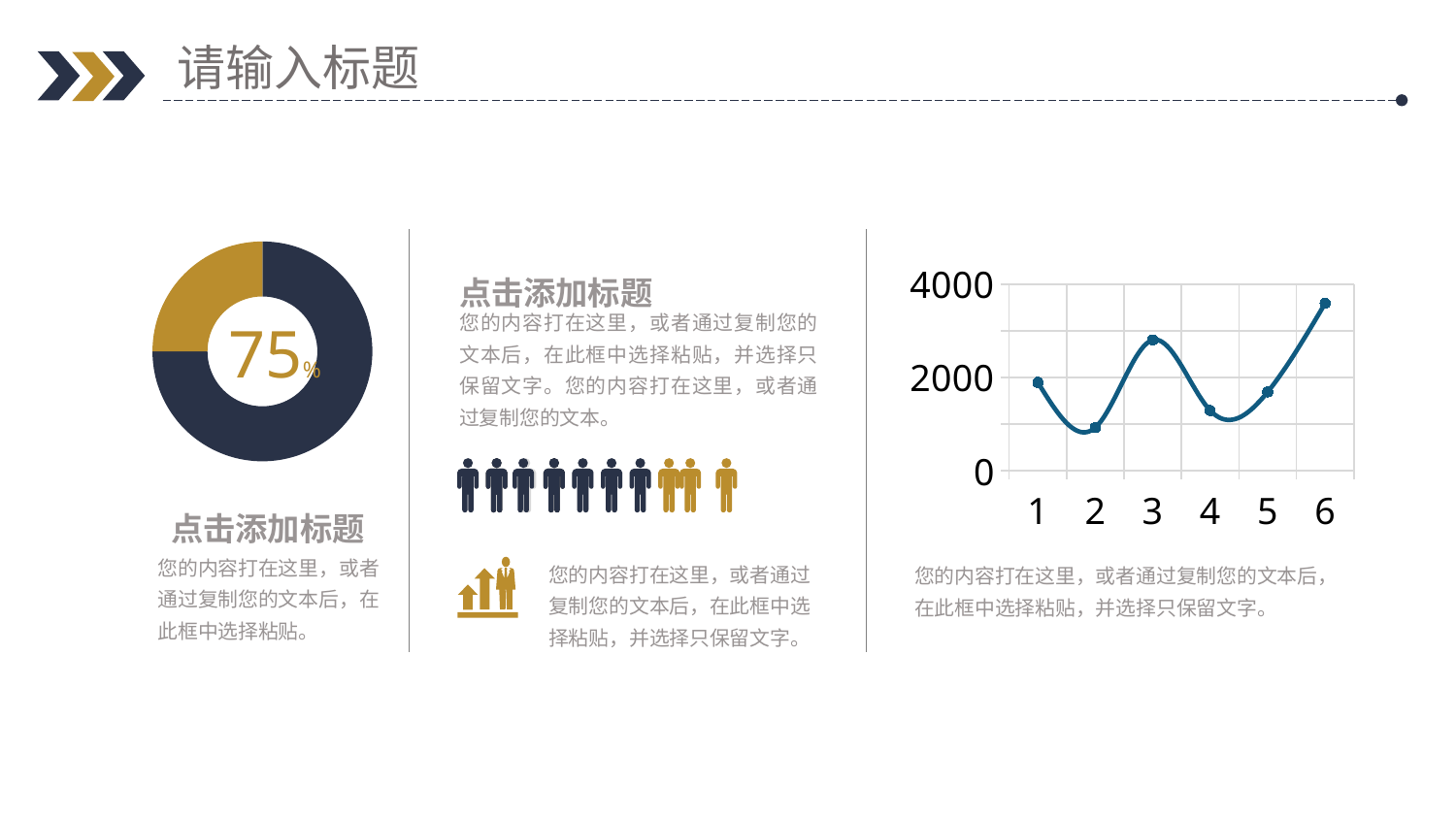
In the line chart on the right, which category has the highest value? 6 What kind of chart is shown on the right side of the slide? line chart In the line chart on the right, is the value for category 2 greater or less than 2000? less What kind of chart is shown on the left side of the slide? donut chart In the line chart on the right, how many data points are plotted? 6 In the line chart on the right, is the value for category 6 greater or less than 2000? greater In the line chart on the right, which category has the lowest value? 2 In the donut chart on the left, what percentage is printed in the centre? 75% In the line chart on the right, is the value for category 3 greater or less than 2000? greater In the line chart on the right, what is the highest value labelled on the vertical axis? 4000 In the line chart on the right, which is larger, the value for category 3 or the value for category 4? 3